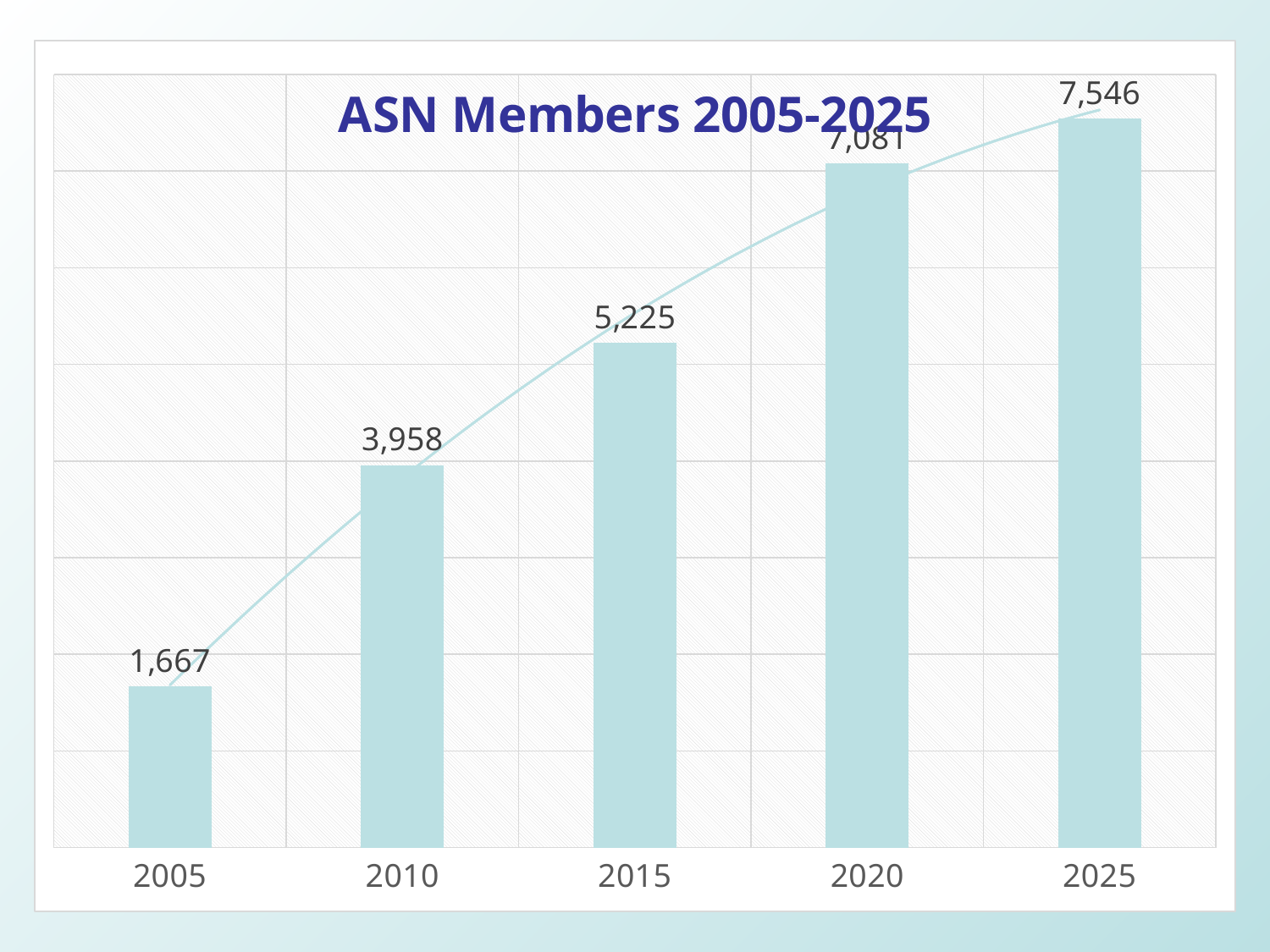
Which year has the highest number of ASN members? 2025 What is the difference in ASN members between 2010 and 2005? 2,291 What is the title of the chart? ASN Members 2005-2025 Do ASN member numbers rise or fall from 2005 to 2025? Rise Which year has more ASN members, 2015 or 2020? 2020 What is the number of ASN members in 2025? 7,546 How many years are shown on the x axis of the chart? 5 What is the difference in ASN members between 2025 and 2020? 465 What is the number of ASN members in 2015? 5,225 What kind of chart is shown on the slide? Bar chart Which year has the lowest number of ASN members? 2005 What is the number of ASN members in 2005? 1,667